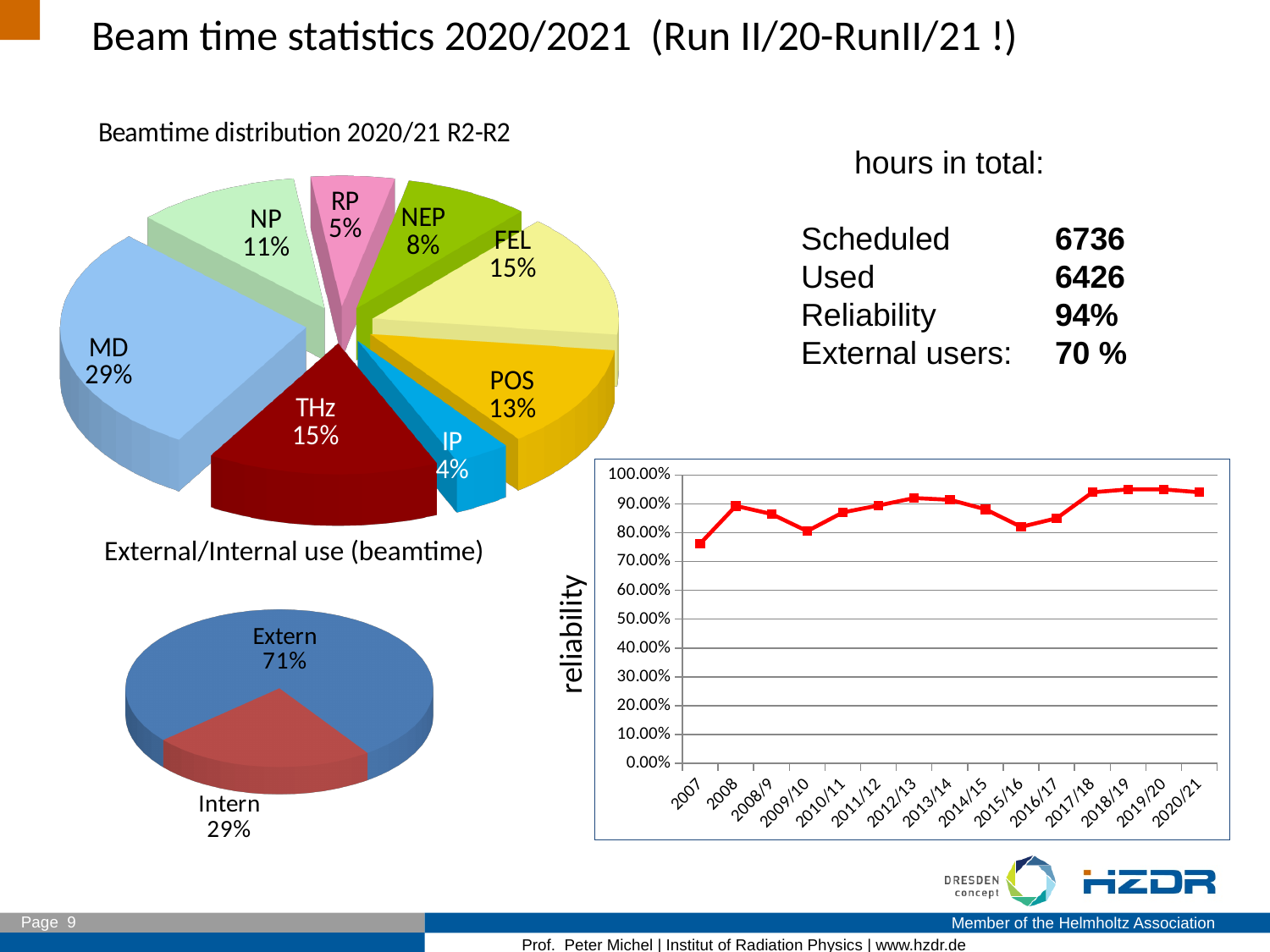
In the 'Beamtime distribution 2020/21 R2-R2' pie chart, what share does MD have? 29% In the 'Beamtime distribution 2020/21 R2-R2' pie chart, which category has the largest share? MD In the reliability chart on the right, which year has the lowest reliability? 2007 In the 'Beamtime distribution 2020/21 R2-R2' pie chart, how many percentage points larger is MD's share than NP's share? 18 In the reliability chart on the right, is the value for 2020/21 greater or less than 90.00%? greater In the 'Beamtime distribution 2020/21 R2-R2' pie chart, what share does POS have? 13% What kind of chart is the 'External/Internal use (beamtime)' chart? pie chart In the 'Beamtime distribution 2020/21 R2-R2' pie chart, which is larger, the share for NEP or the share for RP? NEP How many slices does the 'Beamtime distribution 2020/21 R2-R2' pie chart have? 8 In the reliability chart on the right, is the value for 2015/16 greater or less than 90.00%? less In the 'External/Internal use (beamtime)' pie chart, what share is Extern? 71% In the 'Beamtime distribution 2020/21 R2-R2' pie chart, which category has the smallest share? IP